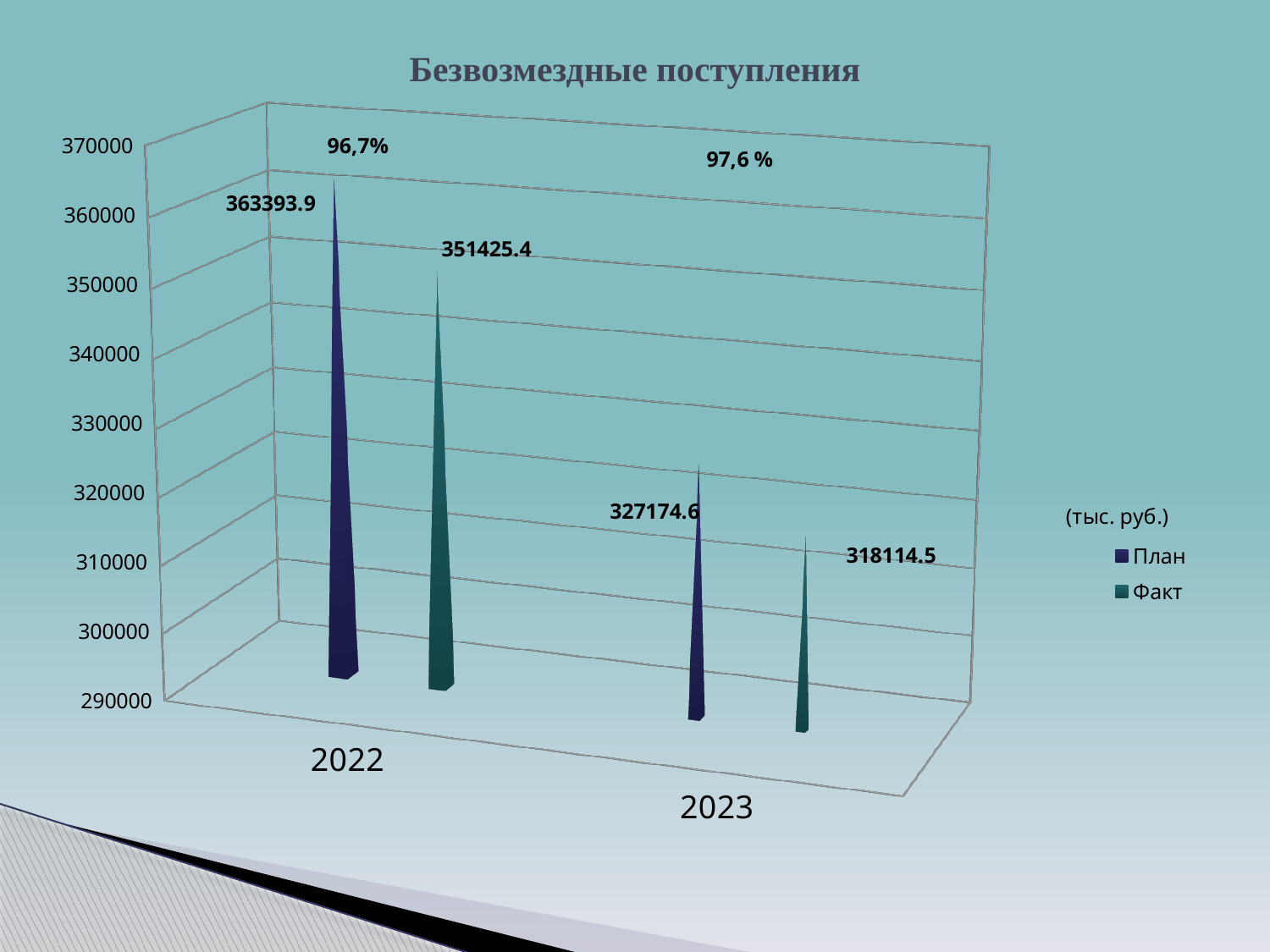
By how much did the План value fall from 2022 to 2023? 36219.3 Which year has the higher Факт value? 2022 What is the title of the chart? Безвозмездные поступления Do the План values rise or fall from 2022 to 2023? fall What is the План value for 2022? 363393.9 Is the План value for 2023 larger or smaller than the Факт value for 2022? smaller Which bar has the lowest value on the chart? Факт 2023 What is the План value for 2023? 327174.6 What is the difference between План and Факт for 2022? 11968.5 What is the Факт value for 2023? 318114.5 What is the Факт value for 2022? 351425.4 How many series does the legend list? 2